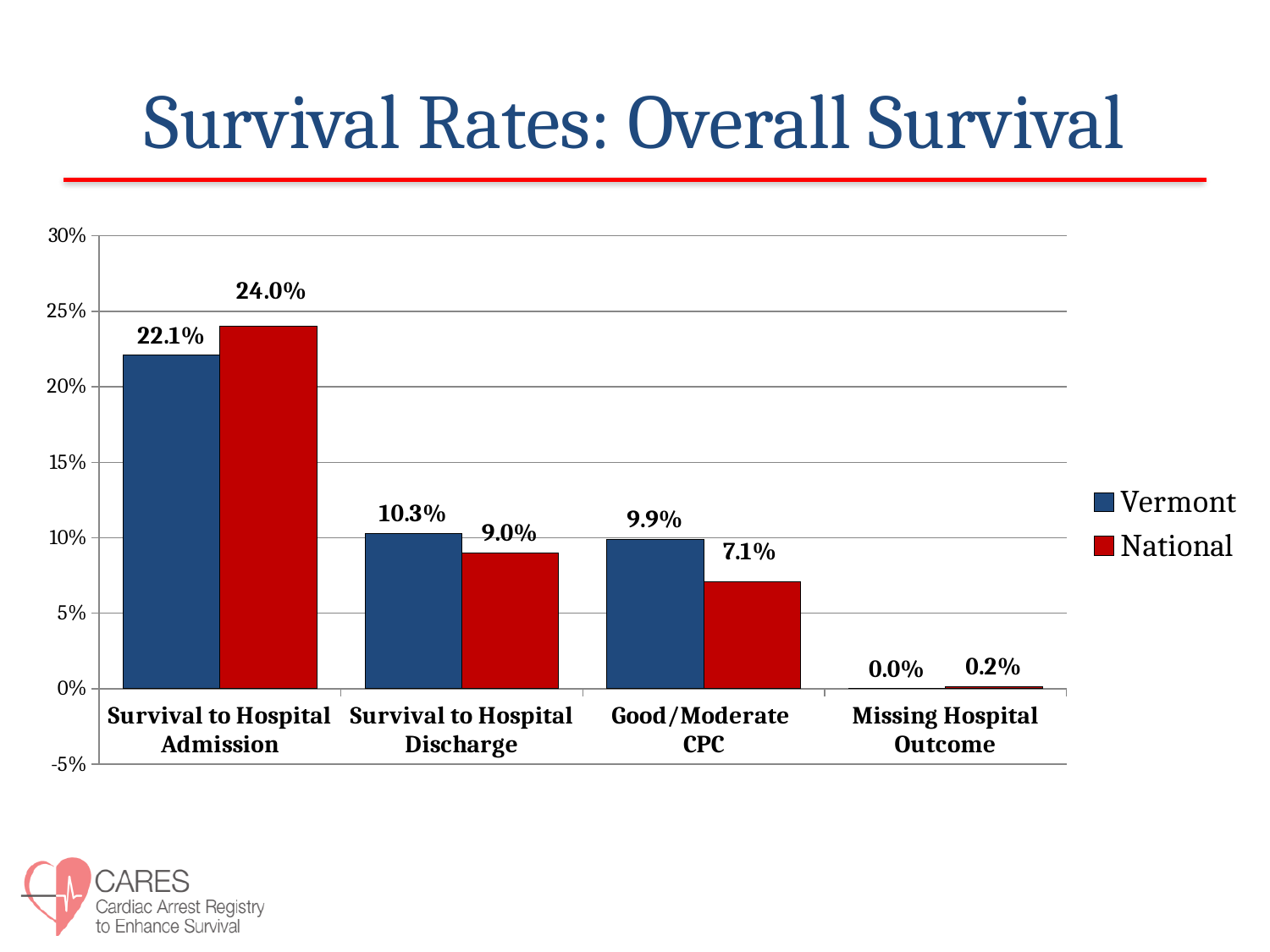
How many series does the legend list? 2 What is the Vermont value for Survival to Hospital Admission? 22.1% What is the National value for Survival to Hospital Discharge? 9.0% Which category has the highest National value? Survival to Hospital Admission What colour are the National bars? Red What is the difference between the National and Vermont values for Survival to Hospital Admission? 1.9% What is the Vermont value for Good/Moderate CPC? 9.9% What kind of chart is shown on the slide? Bar chart What is the National value for Missing Hospital Outcome? 0.2% Which category has the lowest Vermont value? Missing Hospital Outcome Which is larger for Good/Moderate CPC, the Vermont value or the National value? Vermont How many categories are shown on the x axis? 4